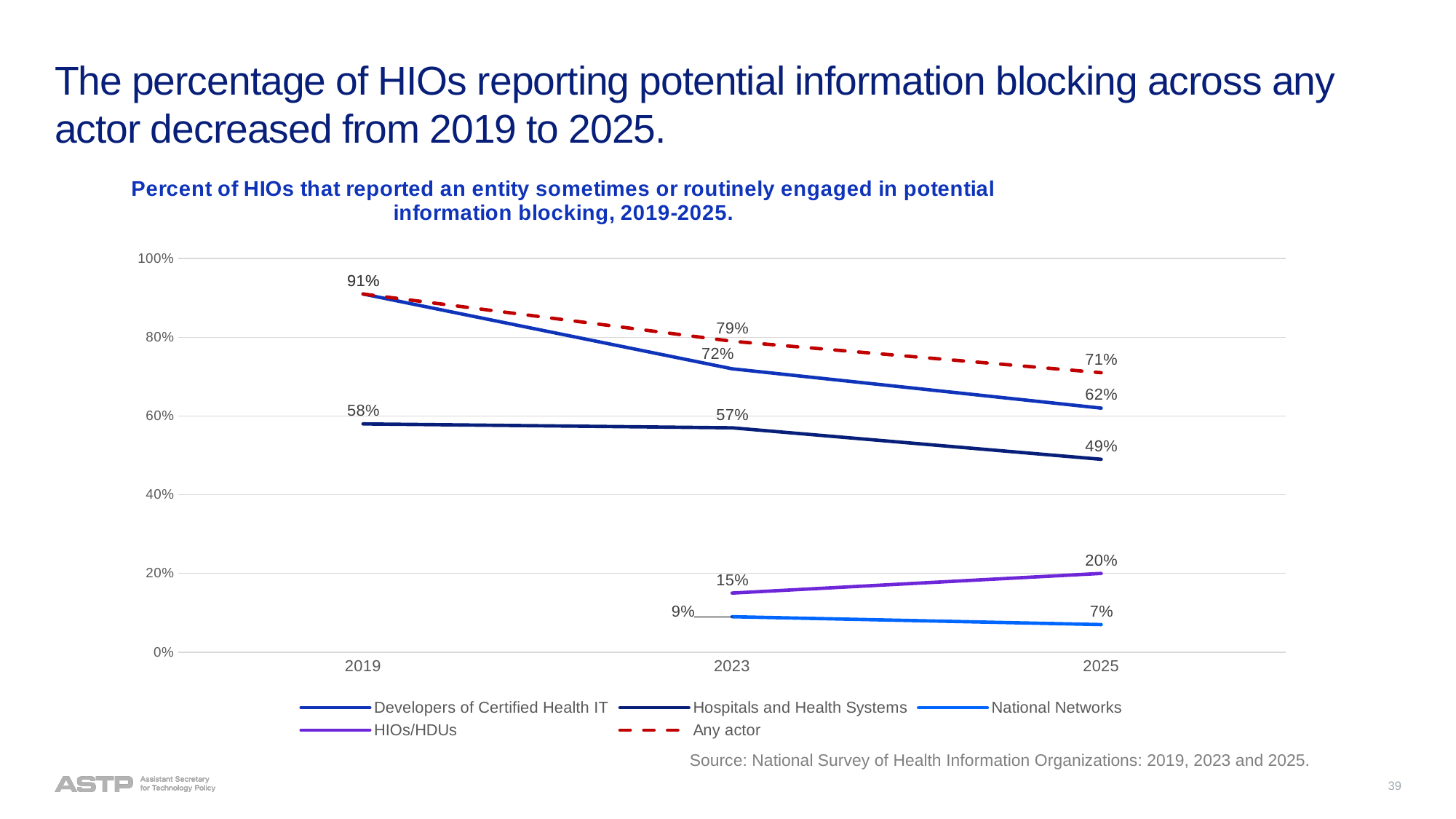
What kind of chart is shown on the slide? Line chart By how many percentage points did the value for Hospitals and Health Systems fall from 2019 to 2025? 9 percentage points How many years are shown on the x axis? 3 Does the value for HIOs/HDUs rise or fall from 2023 to 2025? Rise Which series has the lowest value in 2025? National Networks In 2023, which is larger: the value for Any actor or the value for Developers of Certified Health IT? Any actor What percentage of HIOs reported Developers of Certified Health IT engaged in potential information blocking in 2025? 62% How many series does the legend list? 5 What is the value for Hospitals and Health Systems in 2023? 57% What is the value for HIOs/HDUs in 2023? 15% What is the value for Any actor in 2025? 71% What is the value for National Networks in 2025? 7%